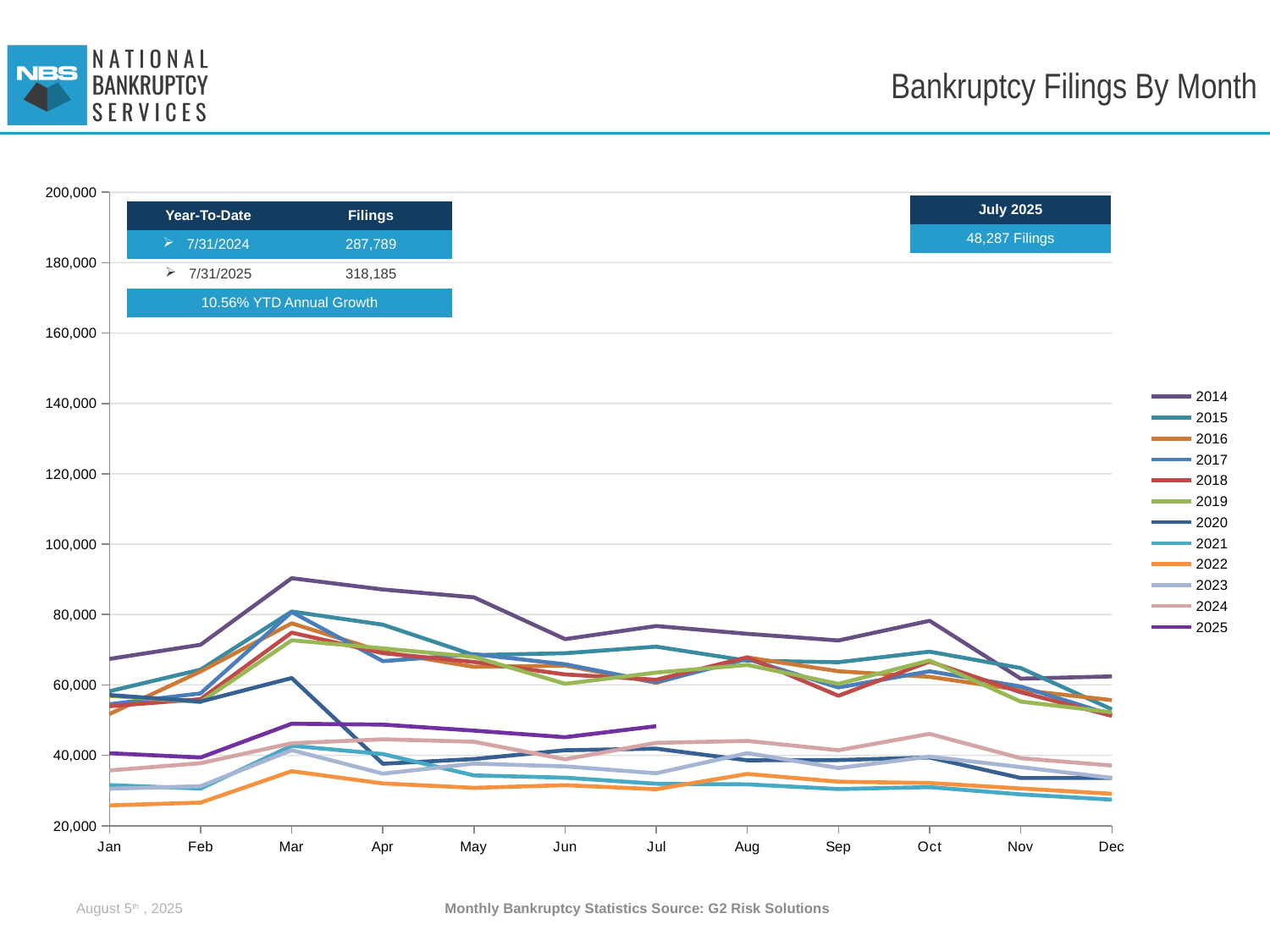
Is the value for 2022 in January greater or less than 40,000? less Which is larger in March, the value for 2014 or the value for 2022? 2014 Is the value for 2025 in March greater or less than 60,000? less Does the 2014 line rise or fall from March to June? fall Is the value for 2014 in March greater or less than 80,000? greater How many months are shown along the x axis? 12 What YTD annual growth percentage is shown in the table on the chart? 10.56% According to the callout, how many filings were there in July 2025? 48,287 Filings Which year has the highest value in March? 2014 Which year has the lowest value in January? 2022 What kind of chart is shown on the slide? line chart How many series does the legend list? 12